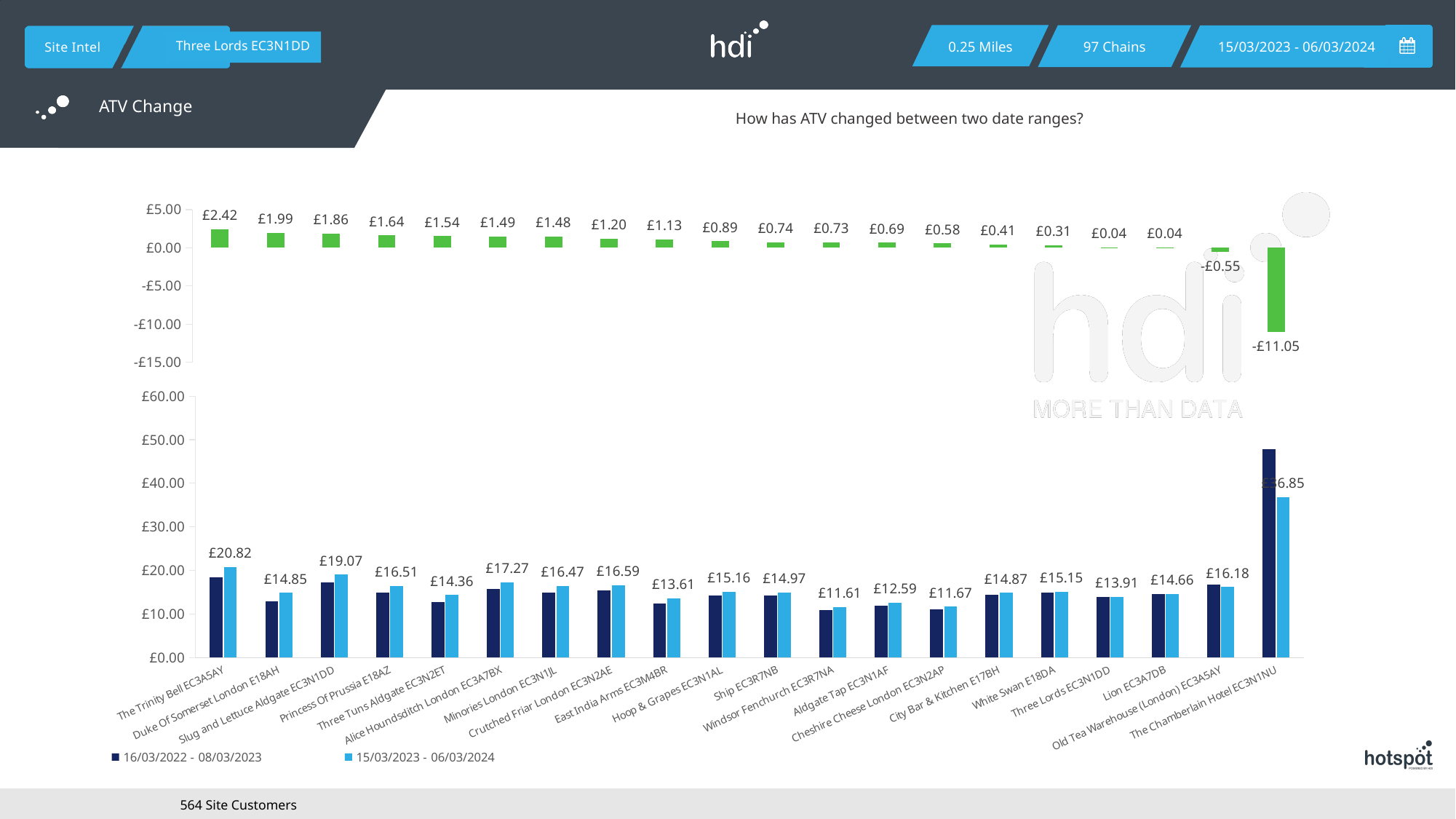
In the bottom chart, what is the value for The Chamberlain Hotel EC3N1NU in the 15/03/2023 - 06/03/2024 series? £36.85 How many series does the legend of the bottom chart list? 2 In the top chart, what is the lowest value shown? -£11.05 How many categories are shown on the x axis of the bottom chart? 20 In the bottom chart, what is the value for The Trinity Bell EC3A5AY in the 15/03/2023 - 06/03/2024 series? £20.82 In the bottom chart, which category has the highest value in the 15/03/2023 - 06/03/2024 series? The Chamberlain Hotel EC3N1NU In the bottom chart, which is larger in the 15/03/2023 - 06/03/2024 series: Slug and Lettuce Aldgate EC3N1DD or Princess Of Prussia E18AZ? Slug and Lettuce Aldgate EC3N1DD In the top chart, what is the highest value shown? £2.42 In the bottom chart, is the value for The Chamberlain Hotel EC3N1NU in the 16/03/2022 - 08/03/2023 series greater or less than £40.00? greater In the bottom chart, what is the difference between The Trinity Bell EC3A5AY and Duke Of Somerset London E18AH in the 15/03/2023 - 06/03/2024 series? £5.97 What kind of chart is the bottom chart? Bar chart In the bottom chart, which category has the lowest labelled value in the 15/03/2023 - 06/03/2024 series? Windsor Fenchurch EC3R7NA